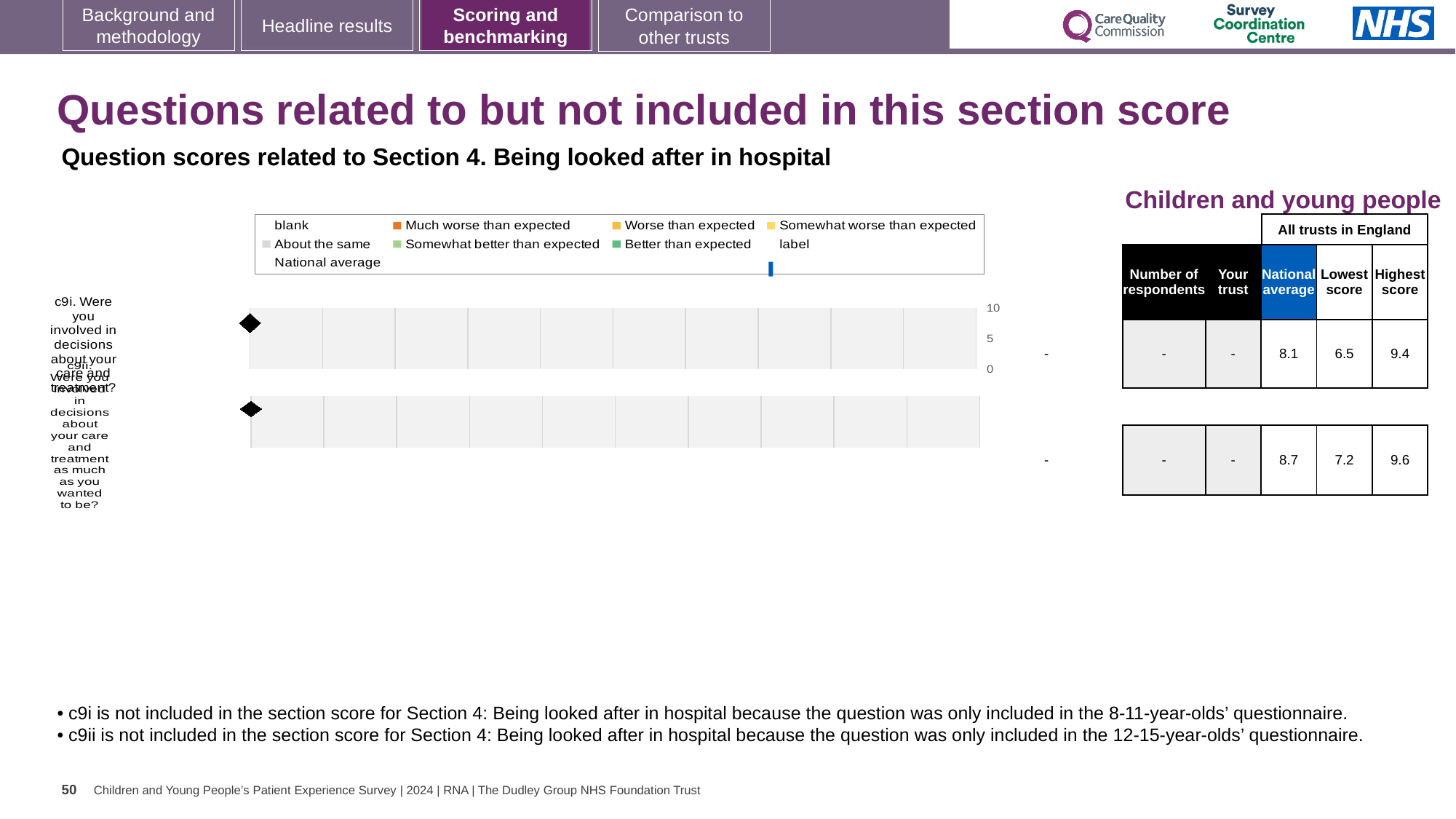
In the table, what is the difference between the national averages of c9ii and c9i? 0.6 Which question has the higher national average in the table, c9i or c9ii? c9ii In the table next to the chart, what is the highest score for c9ii? 9.6 What is the highest value shown on the chart's numeric axis? 10 What colour is the legend marker for 'Much worse than expected'? orange In the table next to the chart, what is the lowest score for c9i? 6.5 What kind of chart is shown on the slide? bar chart How many question categories are plotted on the chart? 2 In the table next to the chart, what is the national average for c9ii? 8.7 In the table, what is the difference between the highest score and the lowest score for c9i? 2.9 Is the national average for c9ii in the table greater or less than 5? greater In the table next to the chart, what is the national average for c9i? 8.1